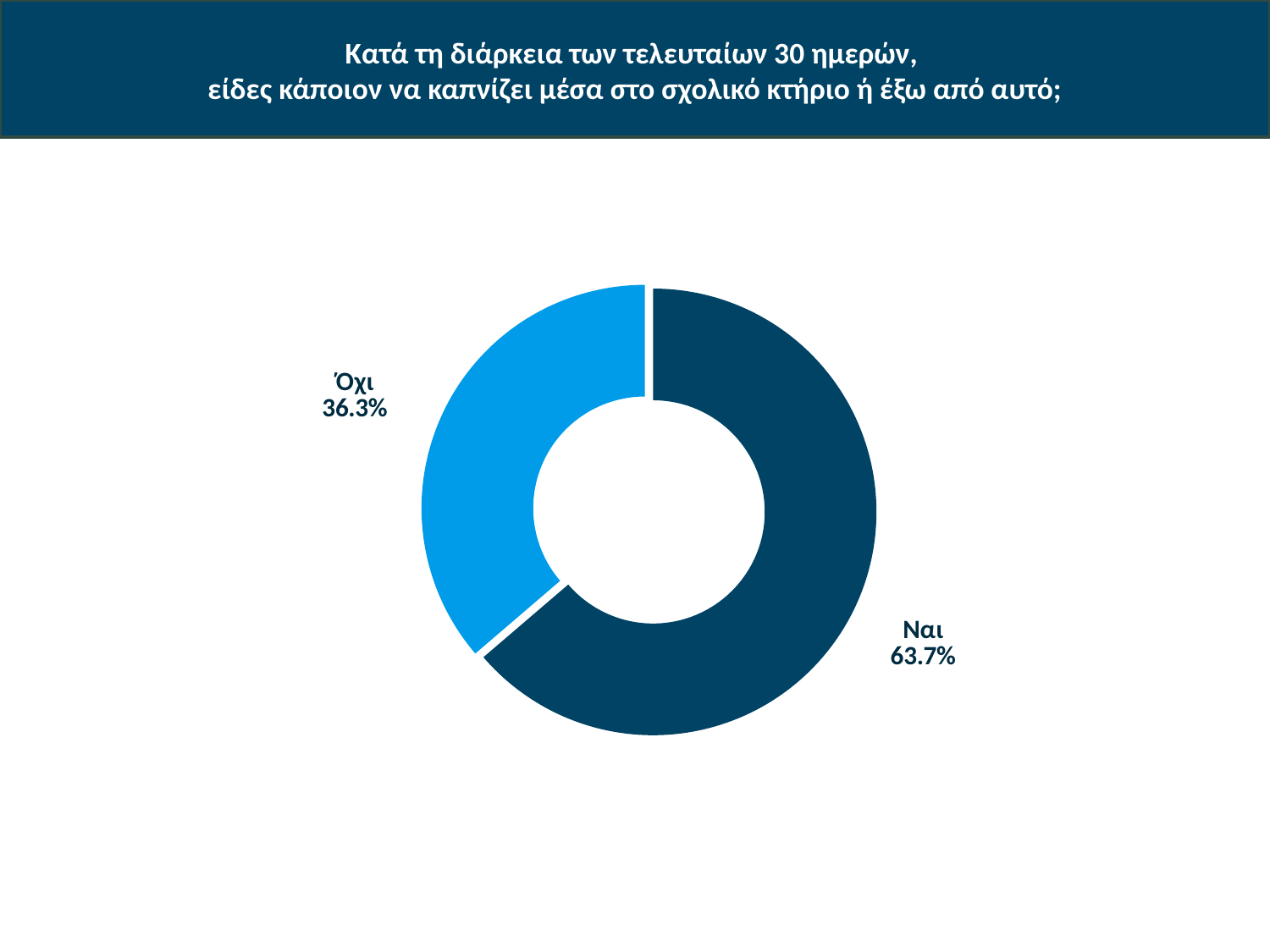
Which response has the smallest share of the chart? Όχι What kind of chart is shown on the slide? Pie chart (doughnut) Is the share for Ναι greater or less than 50%? greater Is the share for Όχι greater or less than 50%? less What percentage of respondents answered Ναι? 63.7% What is the difference in percentage points between the Ναι and Όχι shares? 27.4 What percentage of respondents answered Όχι? 36.3% Which response has the largest share of the chart? Ναι How many categories are shown in the chart? 2 Which colour is used for the Ναι slice? Dark blue Which is larger, the share for Ναι or the share for Όχι? Ναι What share of the pie does the Όχι slice represent? 36.3%